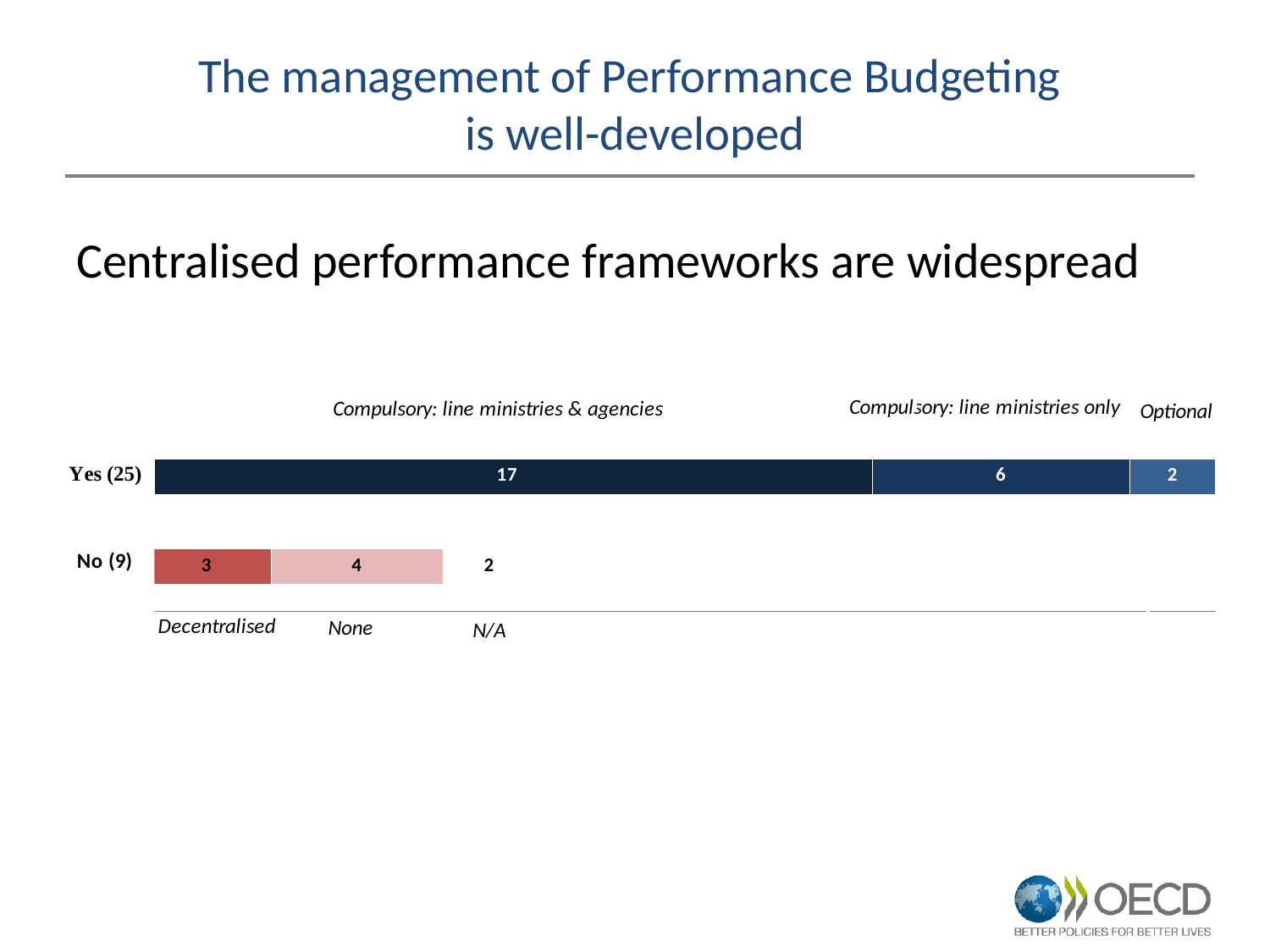
Which is larger in the 'No (9)' bar: the 'Decentralised' segment or the 'None' segment? None What is the difference between the 'Compulsory: line ministries & agencies' segment (17) and the 'Compulsory: line ministries only' segment (6) in the 'Yes (25)' bar? 11 What kind of chart is shown on the slide? stacked bar chart Which segment of the 'Yes (25)' bar is the largest? Compulsory: line ministries & agencies How many bars (categories) does the chart show? 2 What is the value of the 'Optional' segment in the 'Yes (25)' bar? 2 What is the total of the 'Yes (25)' stacked bar? 25 What is the value of the 'Compulsory: line ministries only' segment in the 'Yes (25)' bar? 6 What is the value of the 'None' segment in the 'No (9)' bar? 4 What is the total of the 'No (9)' stacked bar? 9 What is the value of the 'Decentralised' segment in the 'No (9)' bar? 3 What is the value of the 'Compulsory: line ministries & agencies' segment in the 'Yes (25)' bar? 17